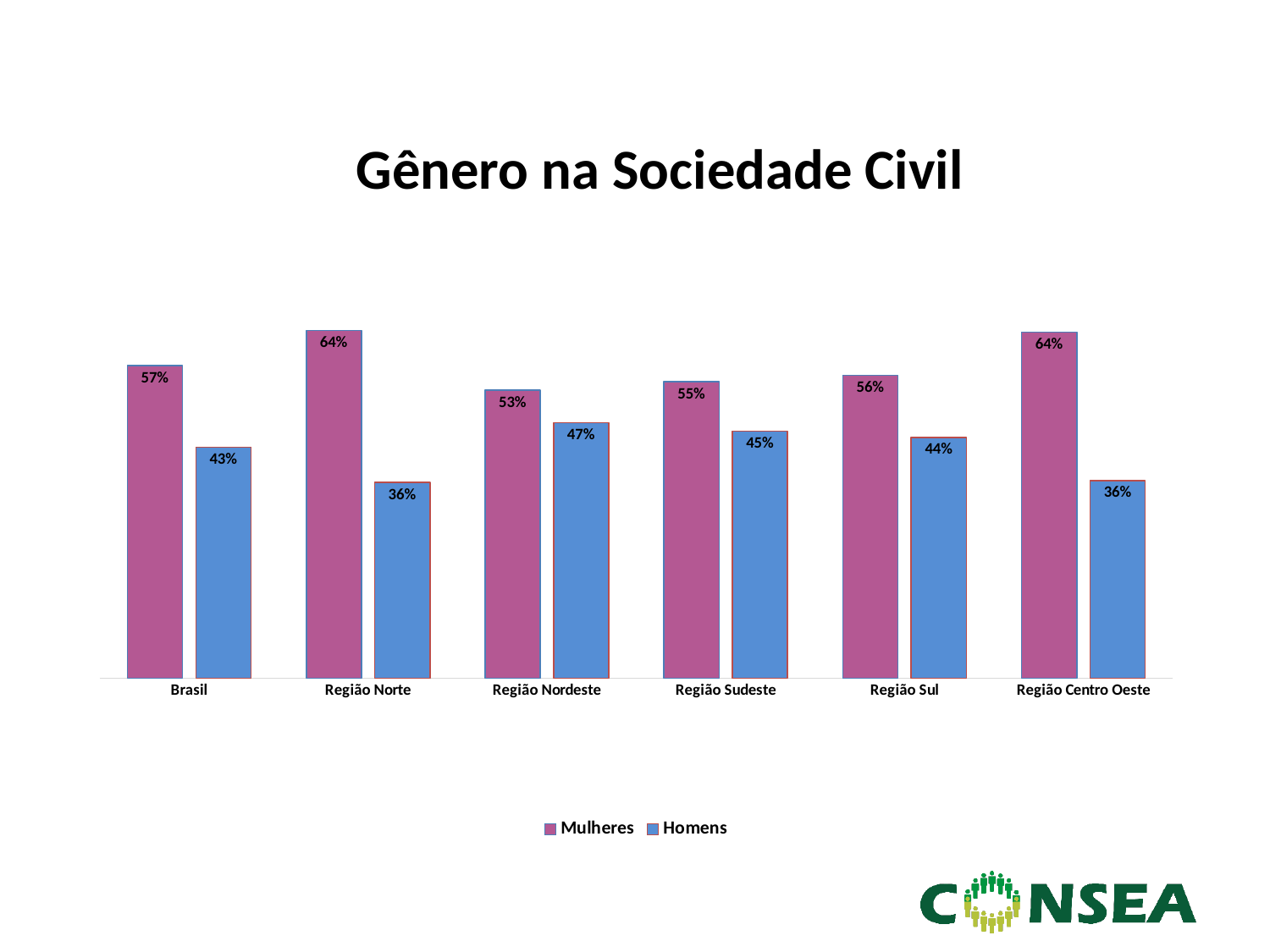
How many categories are shown on the x axis? 6 How many series does the legend list? 2 What is the value for Mulheres in Região Sul? 56% What kind of chart is shown on the slide? Bar chart What is the value for Mulheres in Brasil? 57% Which is larger in Região Sudeste, Mulheres or Homens? Mulheres What is the title of the chart? Gênero na Sociedade Civil Which category has the highest value for Homens? Região Nordeste Which category has the lowest value for Mulheres? Região Nordeste What is the value for Homens in Região Nordeste? 47% What is the value for Homens in Região Norte? 36% What is the difference between Mulheres and Homens in Região Centro Oeste? 28%